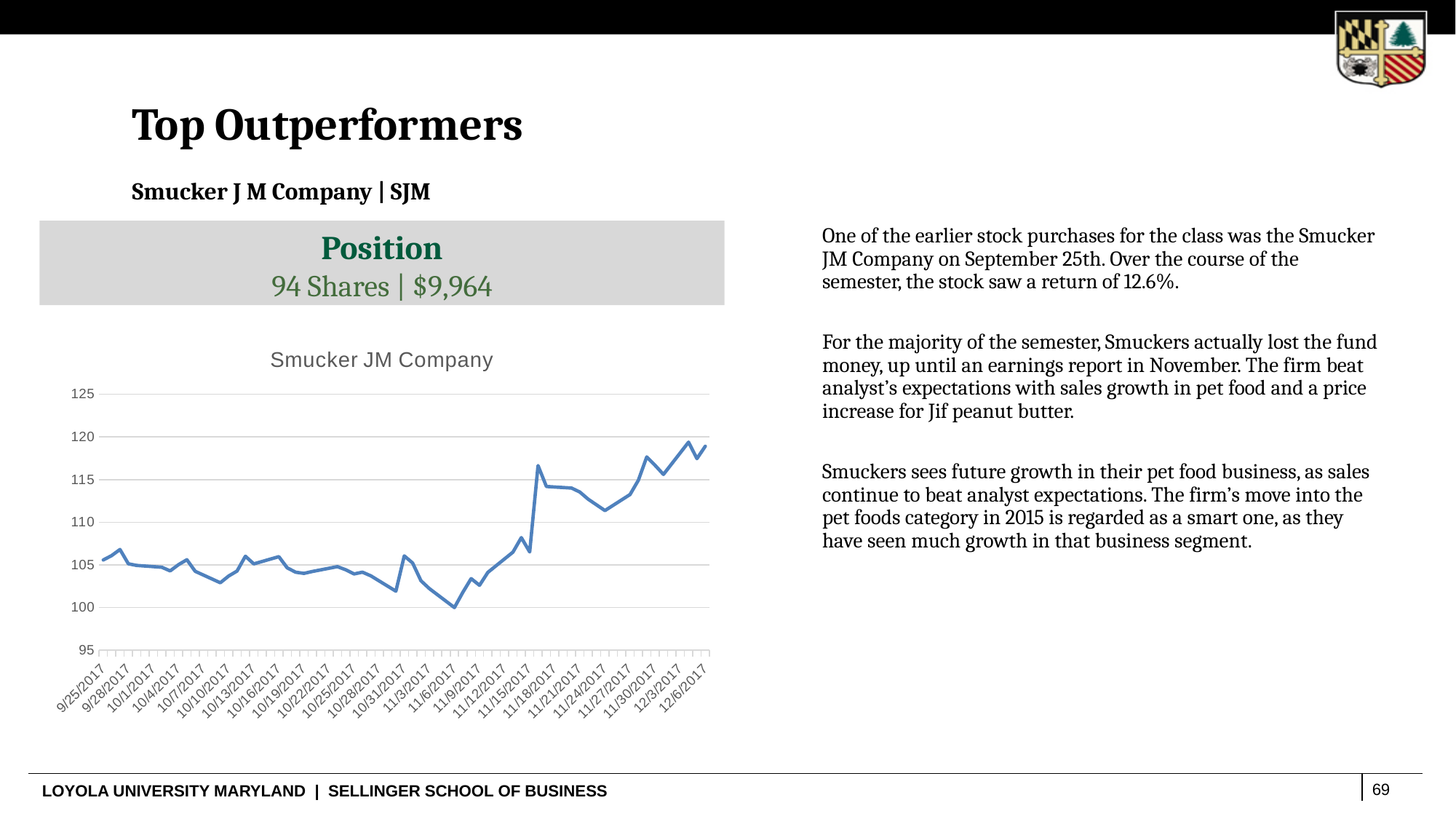
On which date does the line reach its lowest point? 11/6/2017 Is the value for 9/25/2017 greater or less than 110? less Is the value for 10/31/2017 greater or less than 105? greater Which is larger, the value for 12/6/2017 or the value for 9/25/2017? 12/6/2017 Is the value for 12/6/2017 greater or less than 115? greater What is the highest value shown on the y-axis? 125 What is the title of the chart? Smucker JM Company What kind of chart is shown on the slide? line chart Overall, does the line rise or fall from 9/25/2017 to 12/6/2017? rise